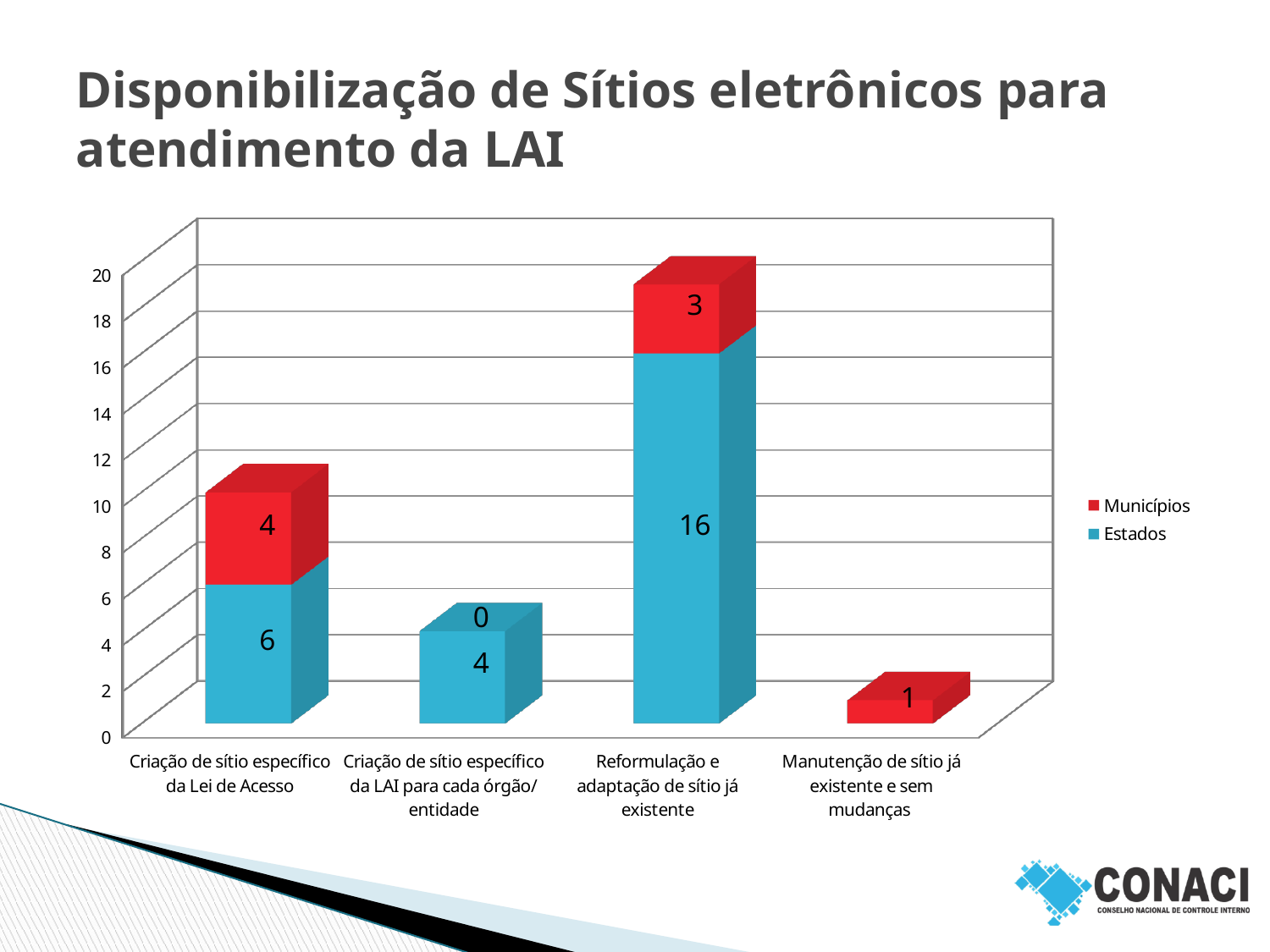
Which category has the highest value for Estados? Reformulação e adaptação de sítio já existente How many series does the legend list? 2 What is the value for Estados in the 'Reformulação e adaptação de sítio já existente' category? 16 How many categories are shown on the x axis? 4 What is the value for Municípios in the 'Criação de sítio específico da Lei de Acesso' category? 4 What is the value for Municípios in the 'Manutenção de sítio já existente e sem mudanças' category? 1 What is the difference between the Estados values for 'Reformulação e adaptação de sítio já existente' and 'Criação de sítio específico da Lei de Acesso'? 10 What is the value for Municípios in the 'Criação de sítio específico da LAI para cada órgão/entidade' category? 0 What is the total of the stacked bar for 'Criação de sítio específico da Lei de Acesso'? 10 Which category has the lowest value for Municípios? Criação de sítio específico da LAI para cada órgão/entidade What is the total of the stacked bar for 'Reformulação e adaptação de sítio já existente'? 19 Which is larger: the Municípios value for 'Criação de sítio específico da Lei de Acesso' or for 'Reformulação e adaptação de sítio já existente'? Criação de sítio específico da Lei de Acesso